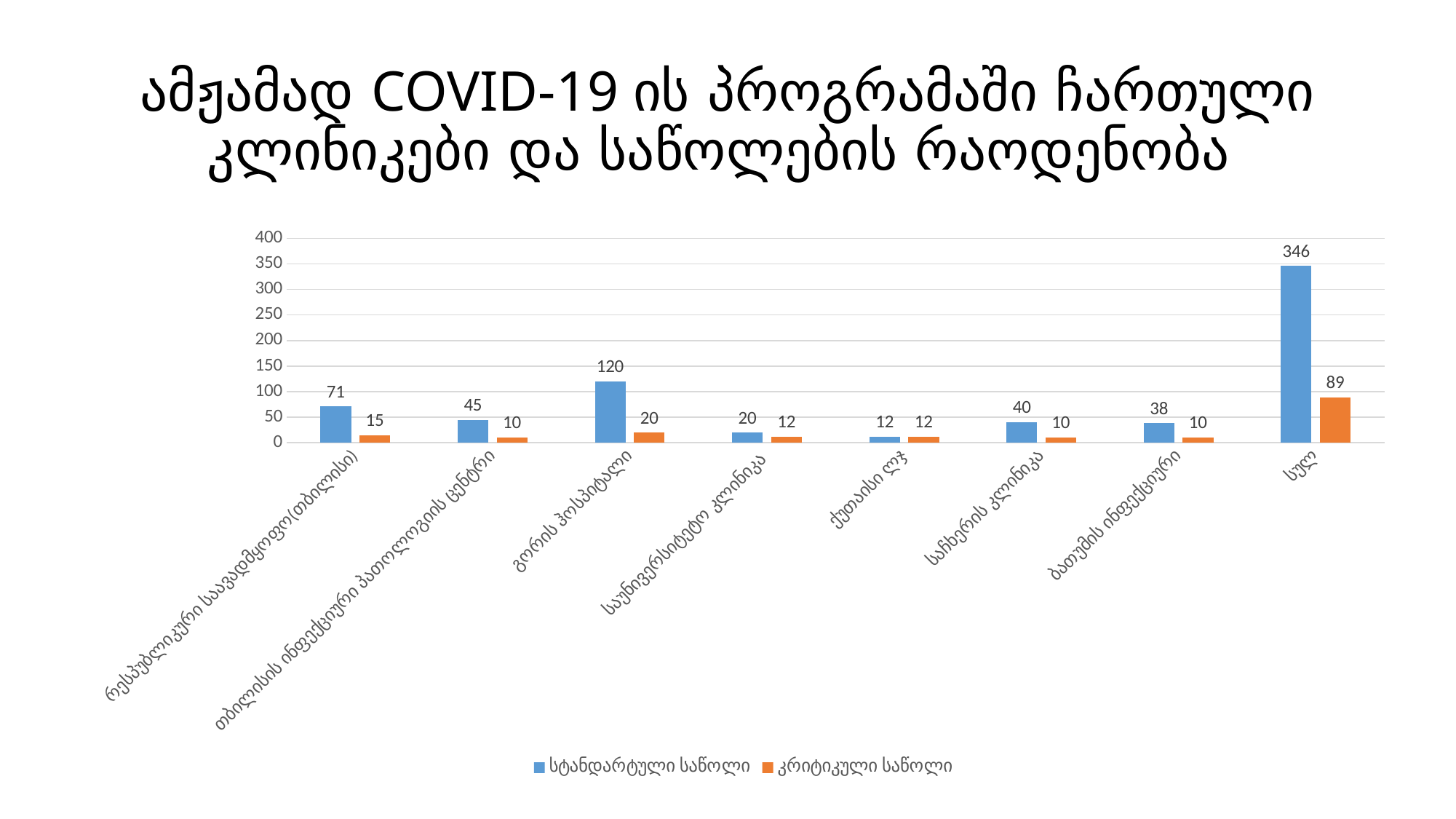
What is the value of სტანდარტული საწოლი for სულ? 346 What is the value of კრიტიკული საწოლი for საუნივერსიტეტო კლინიკა? 12 How many categories are shown on the x axis? 8 What is the difference between სტანდარტული საწოლი and კრიტიკული საწოლი for სულ? 257 What is the difference between the სტანდარტული საწოლი values for რესპუბლიკური საავადმყოფო(თბილისი) and თბილისის ინფექციური პათოლოგიის ცენტრი? 26 Excluding სულ, which category has the highest სტანდარტული საწოლი value? გორის ჰოსპიტალი What is the value of კრიტიკული საწოლი for რესპუბლიკური საავადმყოფო(თბილისი)? 15 How many series does the legend list? 2 Which is larger: სტანდარტული საწოლი for საჩხერის კლინიკა or for ბათუმის ინფექციური? საჩხერის კლინიკა What is the value of სტანდარტული საწოლი for გორის ჰოსპიტალი? 120 What kind of chart is shown on the slide? Bar chart Excluding სულ, which category has the lowest სტანდარტული საწოლი value? ქუთაისი ლჯ